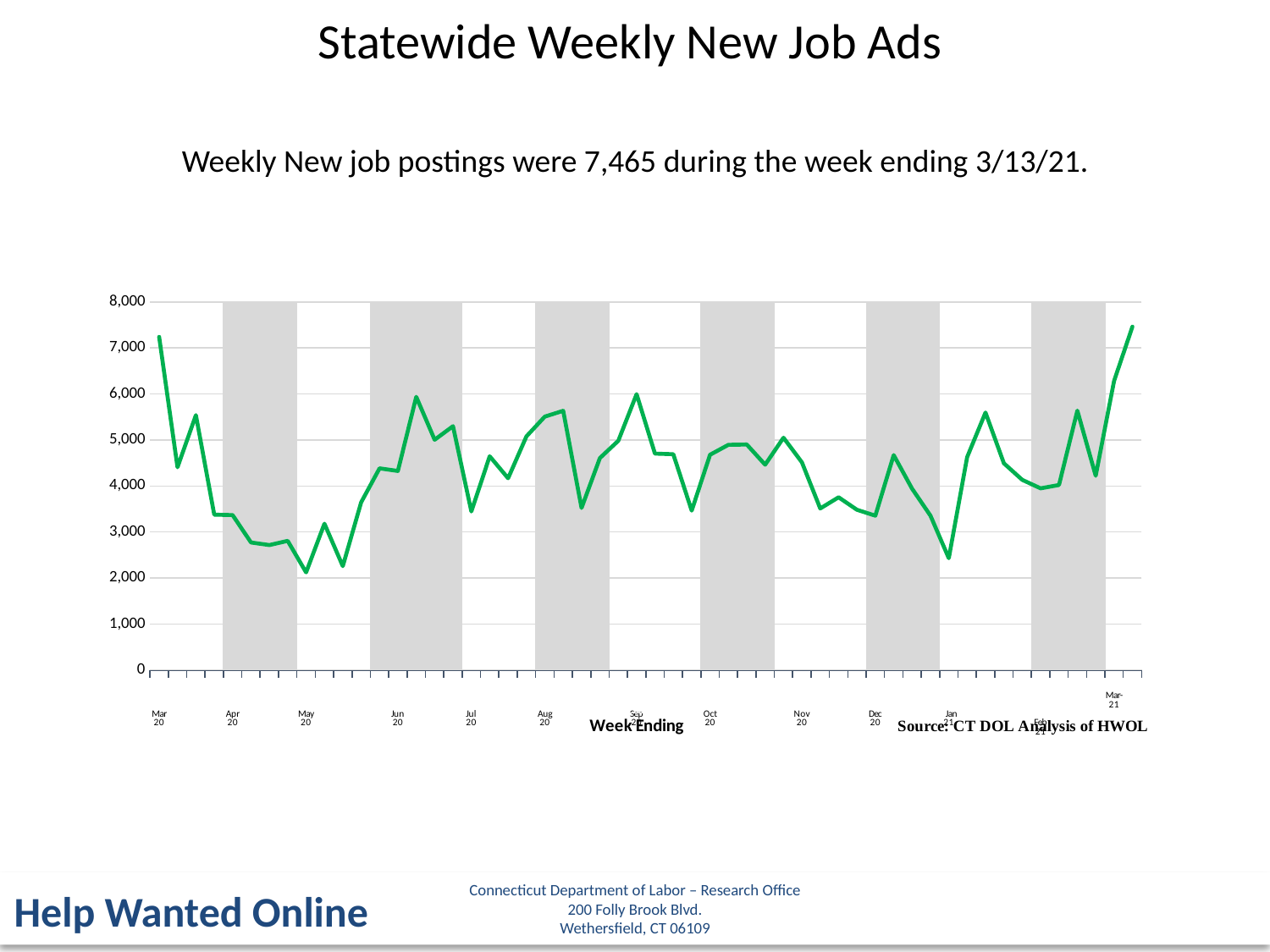
What is the highest value shown on the y axis? 8,000 Is the value around Dec 20 greater or less than 4,000? less Do the values rise or fall from Jan 21 to Mar 21? rise Which is larger, the value at Mar 21 or the value at Dec 20? Mar 21 Is the peak around Jun 20 greater or less than 5,000? greater Is the lowest value around May 20 greater or less than 3,000? less Do the values rise or fall from Mar 20 to May 20? fall What was the number of weekly new job postings for the week ending 3/13/21? 7,465 What is the title of the x axis? Week Ending What kind of chart is shown on the slide? line chart